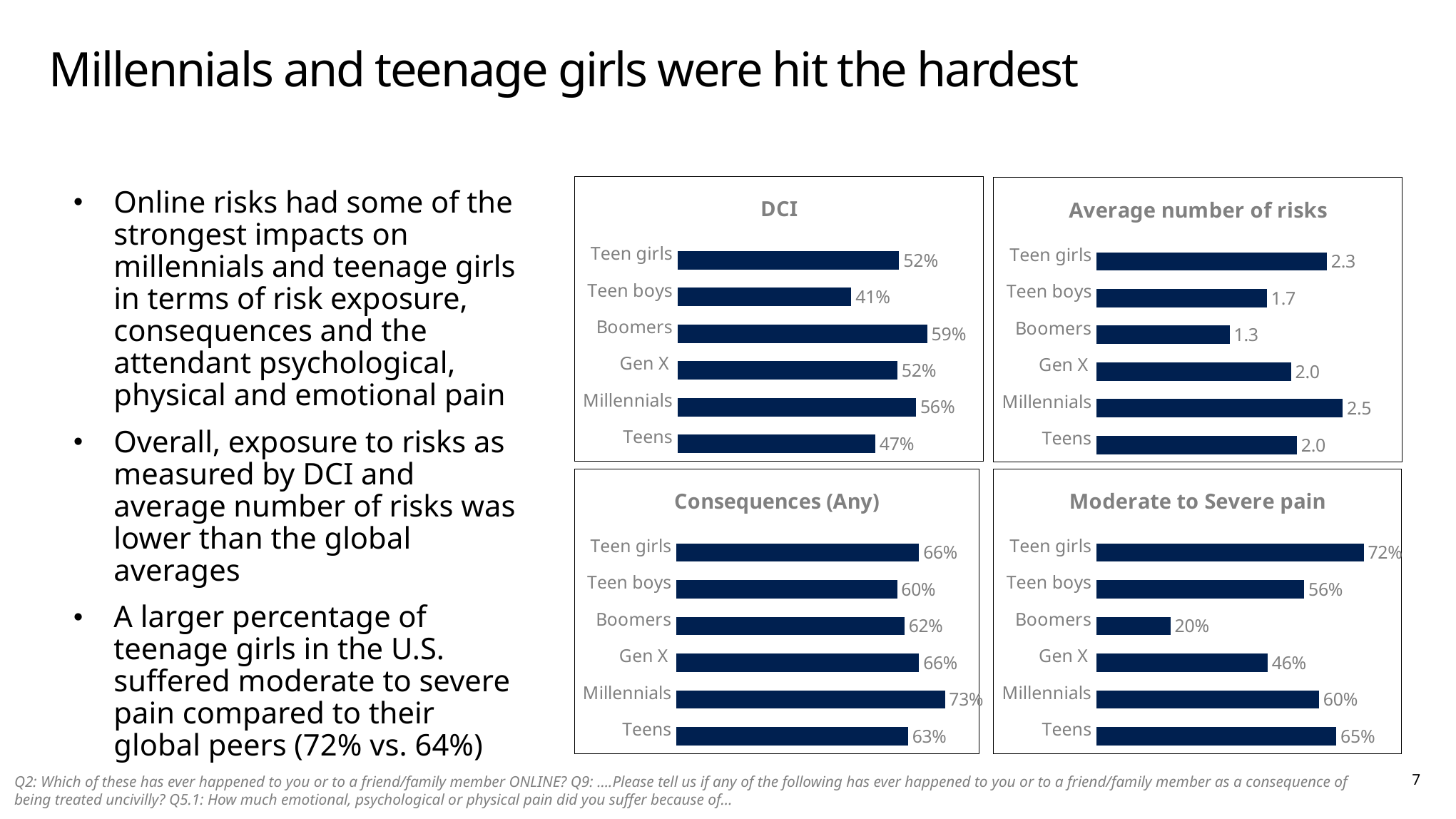
In the Average number of risks chart, what is the difference between Millennials and Boomers? 1.2 How many categories are shown in the Consequences (Any) chart? 6 In the Average number of risks chart, what is the value for Teen boys? 1.7 In the Consequences (Any) chart, what is the value for Millennials? 73% In the DCI chart, which is larger, the value for Teen girls or the value for Teen boys? Teen girls In the Average number of risks chart, which category has the highest value? Millennials What is the title of the chart in the top-right position on the slide? Average number of risks In the Moderate to Severe pain chart, which category has the lowest value? Boomers What type of chart is the Moderate to Severe pain chart? Bar chart In the DCI chart, what is the value for Boomers? 59% In the Moderate to Severe pain chart, what is the difference between Teen girls and Teen boys? 16% In the DCI chart, which category has the lowest value? Teen boys